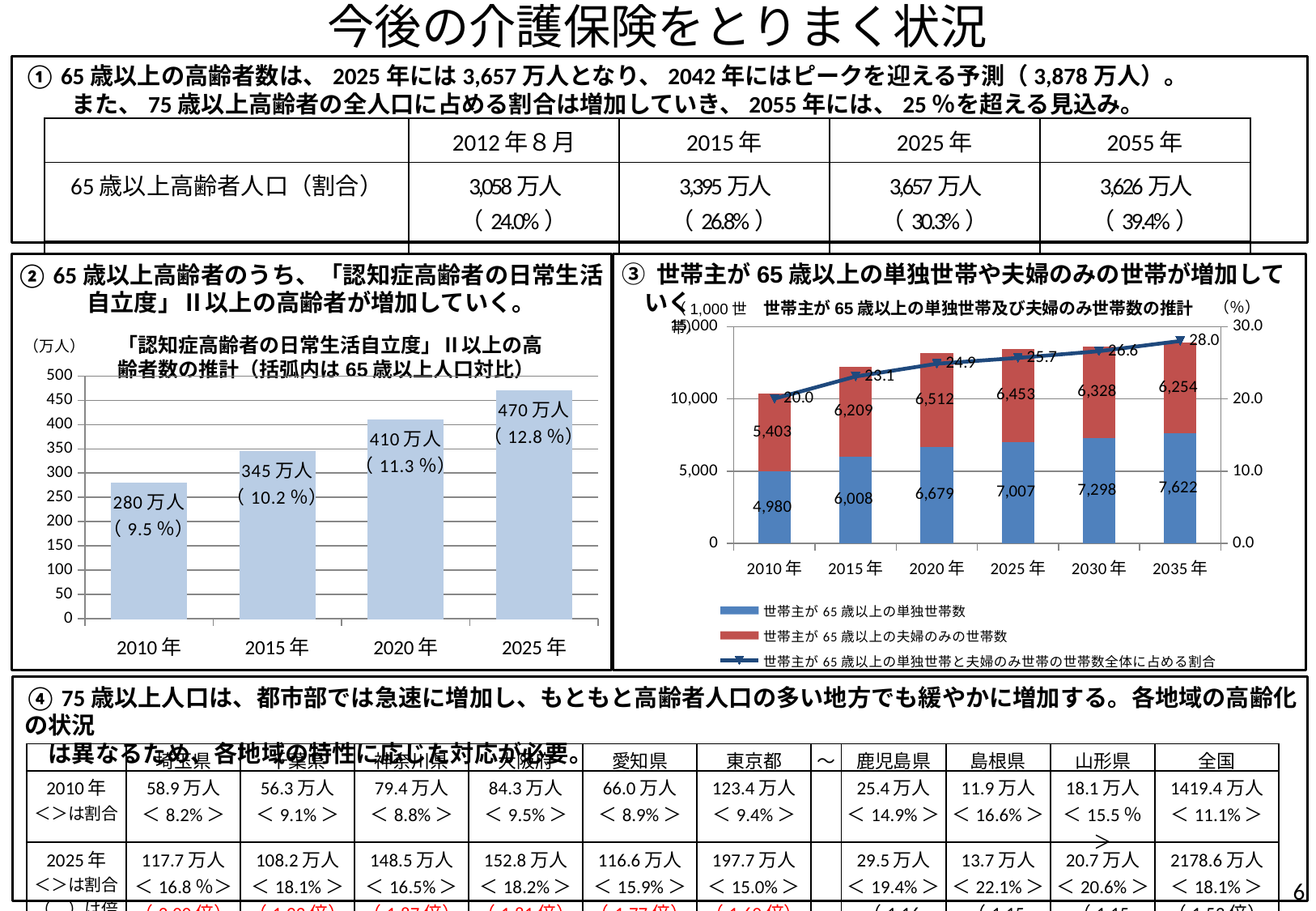
In the right chart, what is the total of the stacked bar for 2035年? 13,876 In the left chart, how many bars are plotted? 4 In the right chart, what is the value of the line series (割合) for 2020年? 24.9 In the right chart, which is larger for 2015年: the 単独世帯数 value or the 夫婦のみの世帯数 value? 夫婦のみの世帯数 In the right chart, how many series does the legend list? 3 In the left chart, what percentage is shown in parentheses for 2025年? 12.8 % In the right chart, what is the value of the 夫婦のみの世帯数 series for 2010年? 5,403 In the left chart, which year has the highest value? 2025 年 In the left chart (認知症高齢者の日常生活自立度 II 以上の高齢者数の推計), what is the value for 2010年? 280 万人 In the left chart, what is the difference between the 2025年 value and the 2010年 value? 190 万人 In the left chart, do the values rise or fall from 2010年 to 2025年? rise In the right chart (世帯主が 65 歳以上の単独世帯及び夫婦のみ世帯数の推計), what is the value of the 単独世帯数 series for 2035年? 7,622